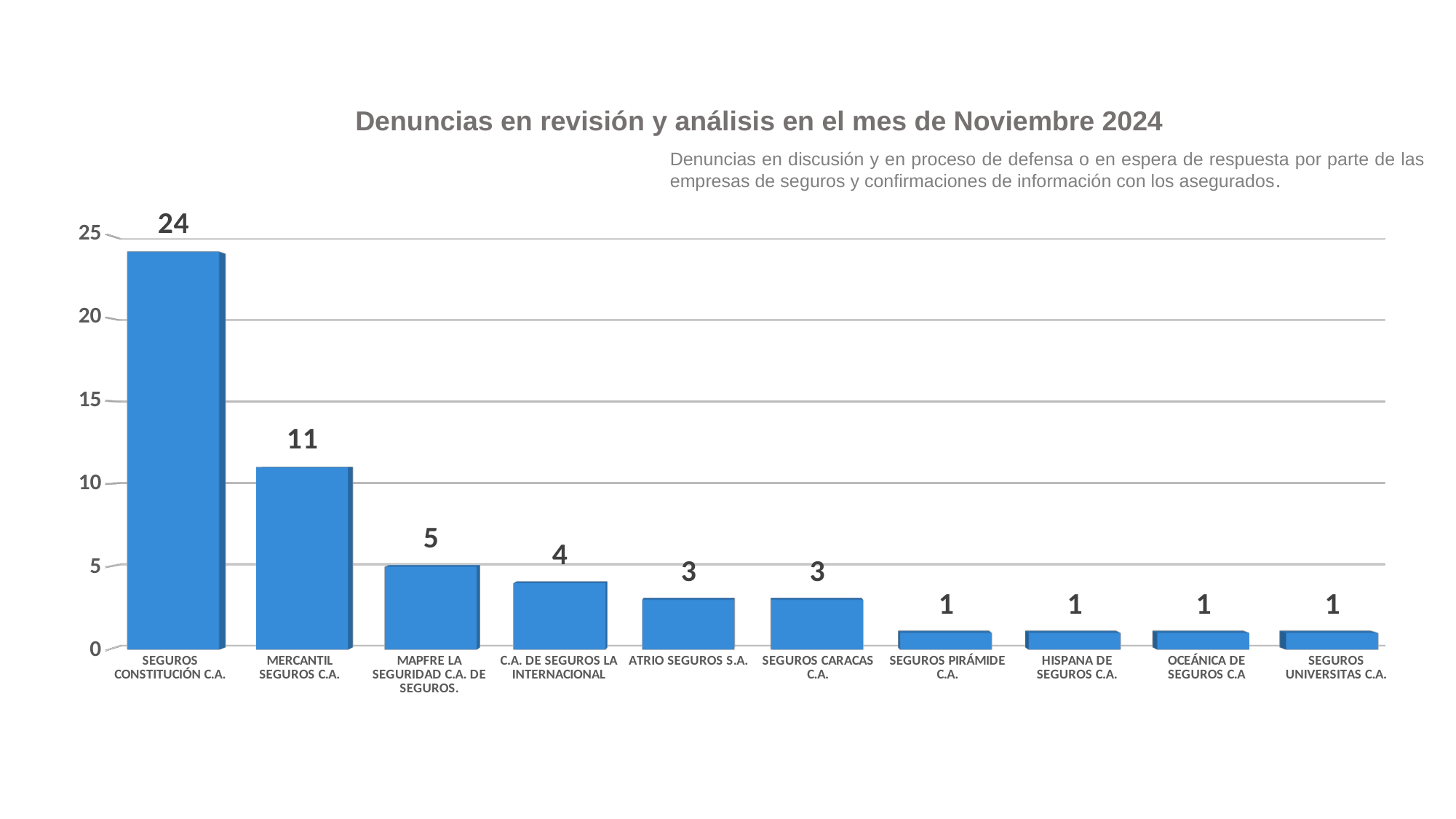
Which category has the highest value? SEGUROS CONSTITUCIÓN C.A. What is the value for MERCANTIL SEGUROS C.A.? 11 What is the title of the chart? Denuncias en revisión y análisis en el mes de Noviembre 2024 What kind of chart is shown on the slide? bar chart What is the value for SEGUROS CONSTITUCIÓN C.A.? 24 What is the value for C.A. DE SEGUROS LA INTERNACIONAL? 4 Which is larger, the value for MAPFRE LA SEGURIDAD C.A. DE SEGUROS. or the value for ATRIO SEGUROS S.A.? MAPFRE LA SEGURIDAD C.A. DE SEGUROS. How many categories are shown in the chart? 10 Is the value for MERCANTIL SEGUROS C.A. greater or less than 10? greater Do the values rise or fall from left to right along the x axis? fall What is the difference between the values for SEGUROS CONSTITUCIÓN C.A. and MERCANTIL SEGUROS C.A.? 13 What is the value for MAPFRE LA SEGURIDAD C.A. DE SEGUROS.? 5